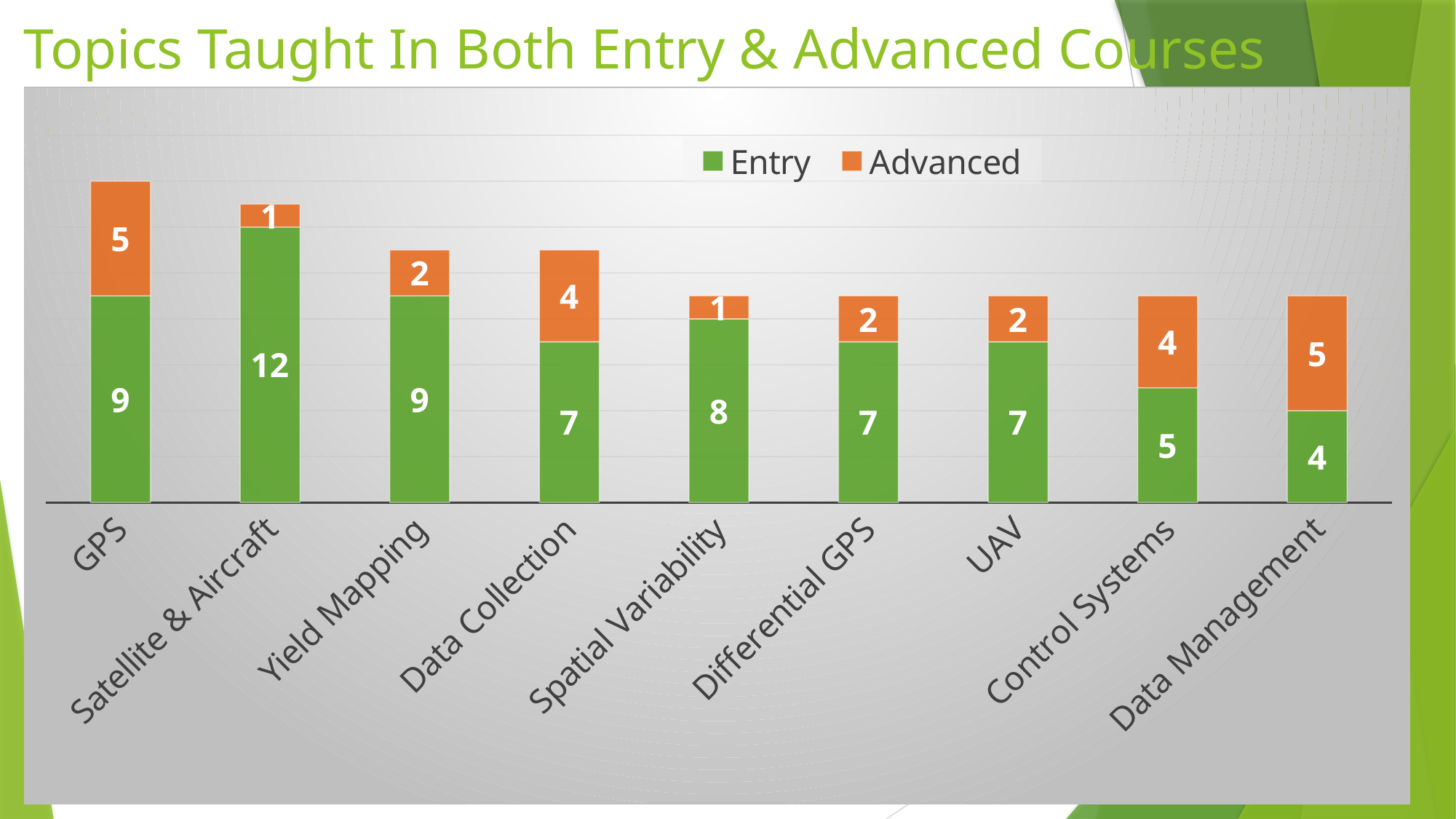
How many series does the legend list? 2 How many categories are shown on the x axis? 9 What is the Advanced value for Data Collection? 4 What is the total of the stacked bar for Control Systems? 9 What is the Entry value for Satellite & Aircraft? 12 What is the total of the stacked bar for GPS? 14 Which is larger, the Advanced value for GPS or the Advanced value for Yield Mapping? GPS What is the difference between the Entry and Advanced values for Spatial Variability? 7 What is the Entry value for Data Management? 4 Which category has the lowest Entry value? Data Management What kind of chart is shown on the slide? Stacked bar chart Which category has the highest Entry value? Satellite & Aircraft